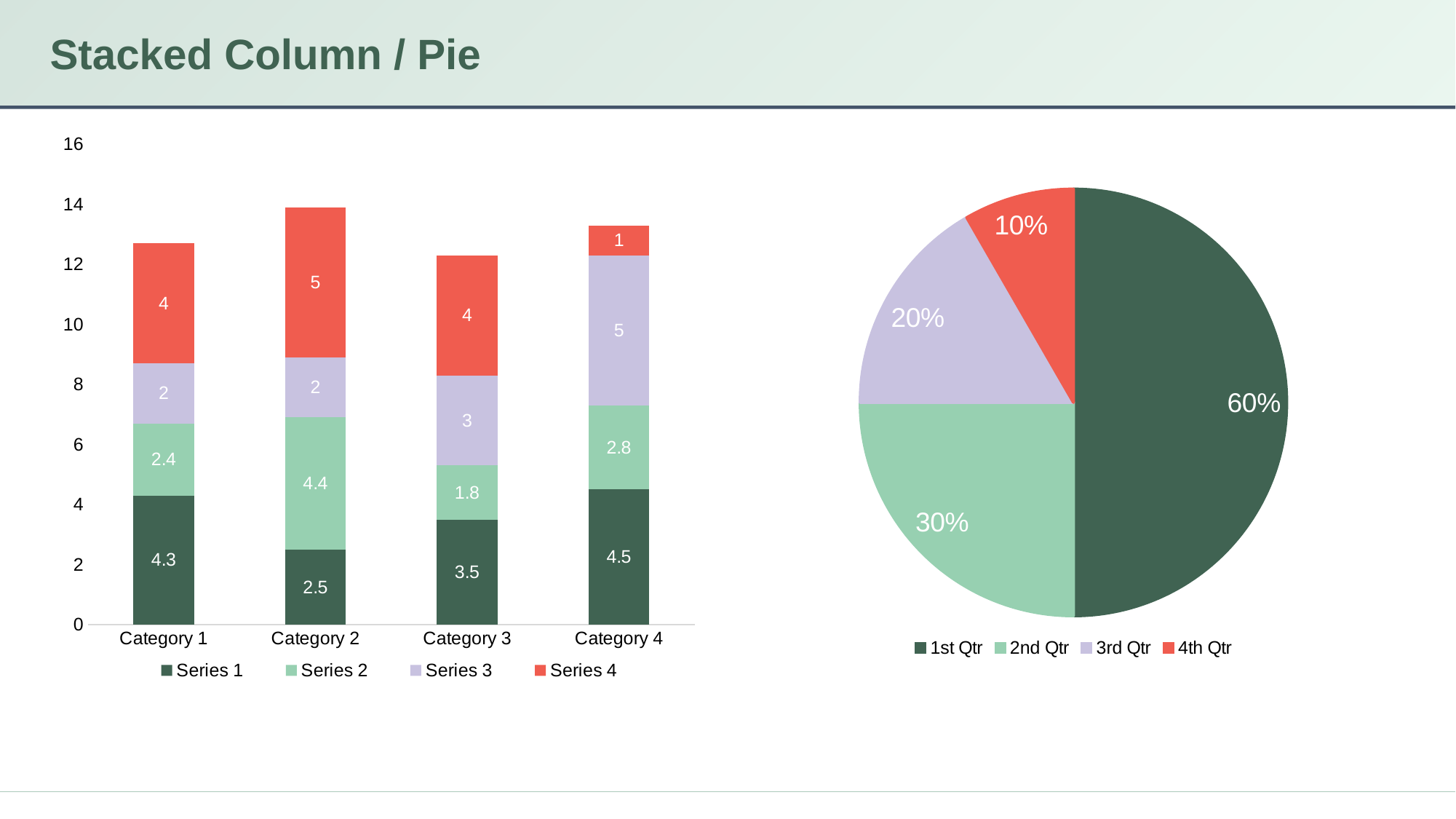
In the stacked bar chart on the left, what is the total of the stacked bar for Category 4? 13.3 In the stacked bar chart on the left, what is the value of Series 1 for Category 1? 4.3 In the stacked bar chart on the left, what is the value of Series 3 for Category 4? 5 In the pie chart on the right, which slice is the smallest? 4th Qtr In the pie chart on the right, what share is labelled for 1st Qtr? 60% What kind of chart is shown on the right side of the slide? Pie chart In the stacked bar chart on the left, what is the total of the stacked bar for Category 2? 13.9 In the stacked bar chart on the left, which category has the highest Series 2 value? Category 2 In the stacked bar chart on the left, what is the difference between the Series 1 values for Category 4 and Category 2? 2 In the stacked bar chart on the left, which category has the lowest Series 4 value? Category 4 In the stacked bar chart on the left, what is the value of Series 4 for Category 2? 5 In the stacked bar chart on the left, how many series does the legend list? 4